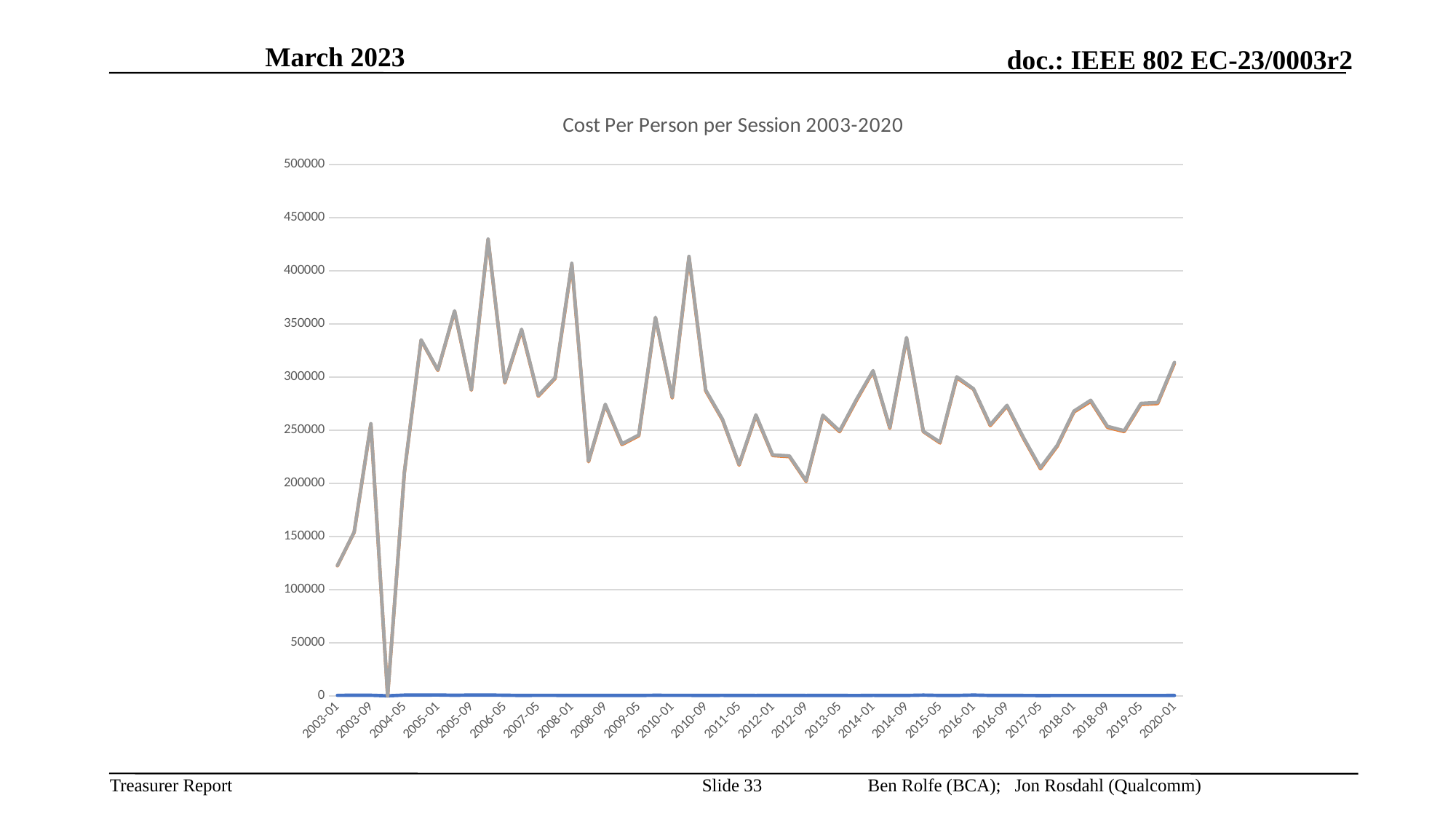
What is the title of the chart? Cost Per Person per Session 2003-2020 Does the value rise or fall from 2003-01 to 2003-09? rise Is the value for 2017-05 greater or less than 250000? less Which is larger, the value for 2008-01 or the value for 2003-01? 2008-01 What type of chart is shown on the slide? line chart Is the value for 2008-01 greater or less than 400000? greater Is the value for 2020-01 greater or less than 300000? greater What is the highest value shown on the vertical axis? 500000